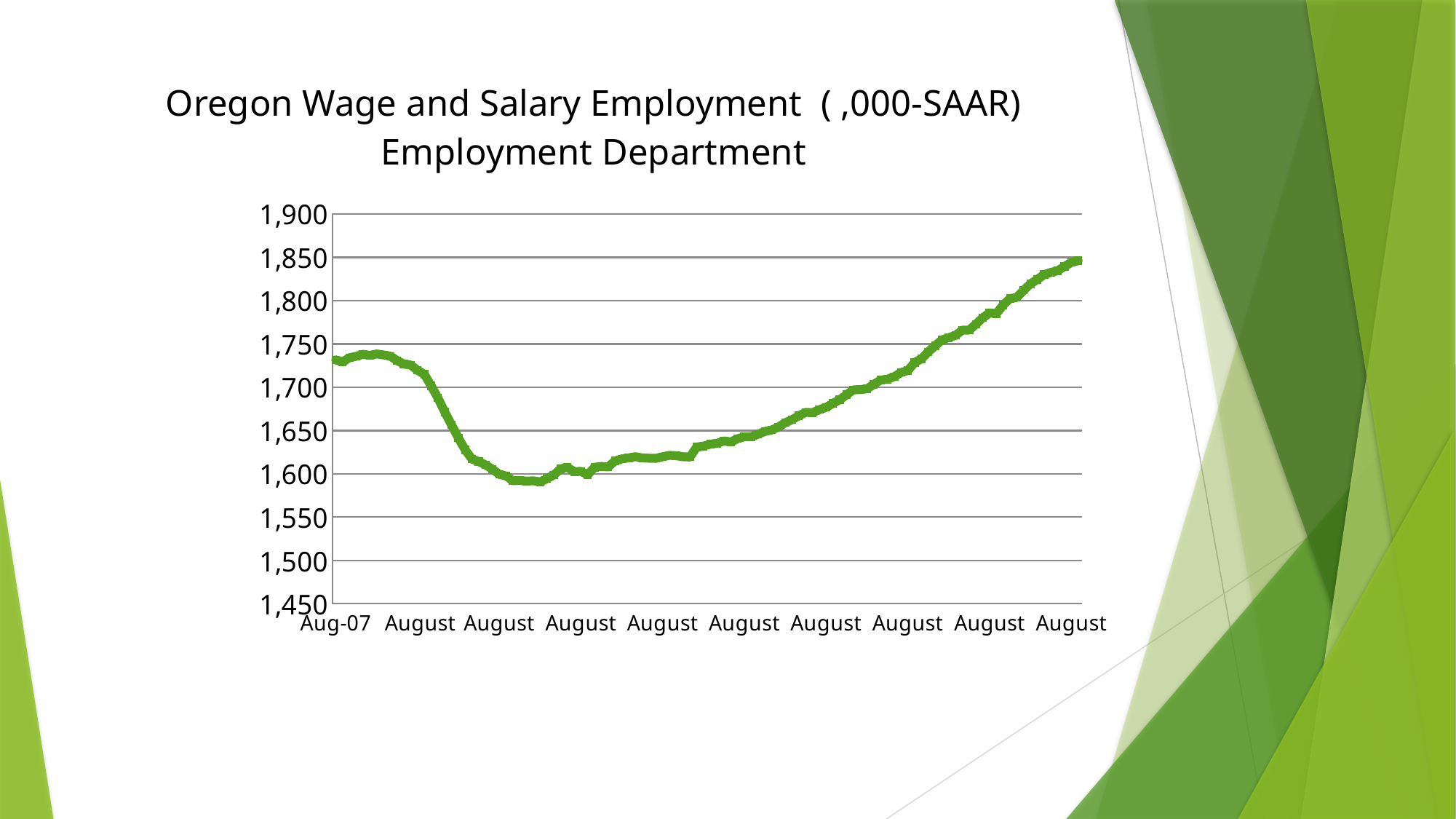
What is the highest value shown on the y axis? 1,900 Is the value at Aug-07 greater or less than 1,750? less Does the line rise or fall over the second half of the x axis? rise How many labels are shown on the x axis? 10 Is the value at the third August label on the x axis greater or less than 1,650? less What is the title of the chart? Oregon Wage and Salary Employment ( ,000-SAAR) Employment Department Comparing the start of the line (Aug-07) with the end of the line (final August), which is higher? the final August Is the lowest point of the line greater or less than 1,650? less What kind of chart is shown on the slide? line chart